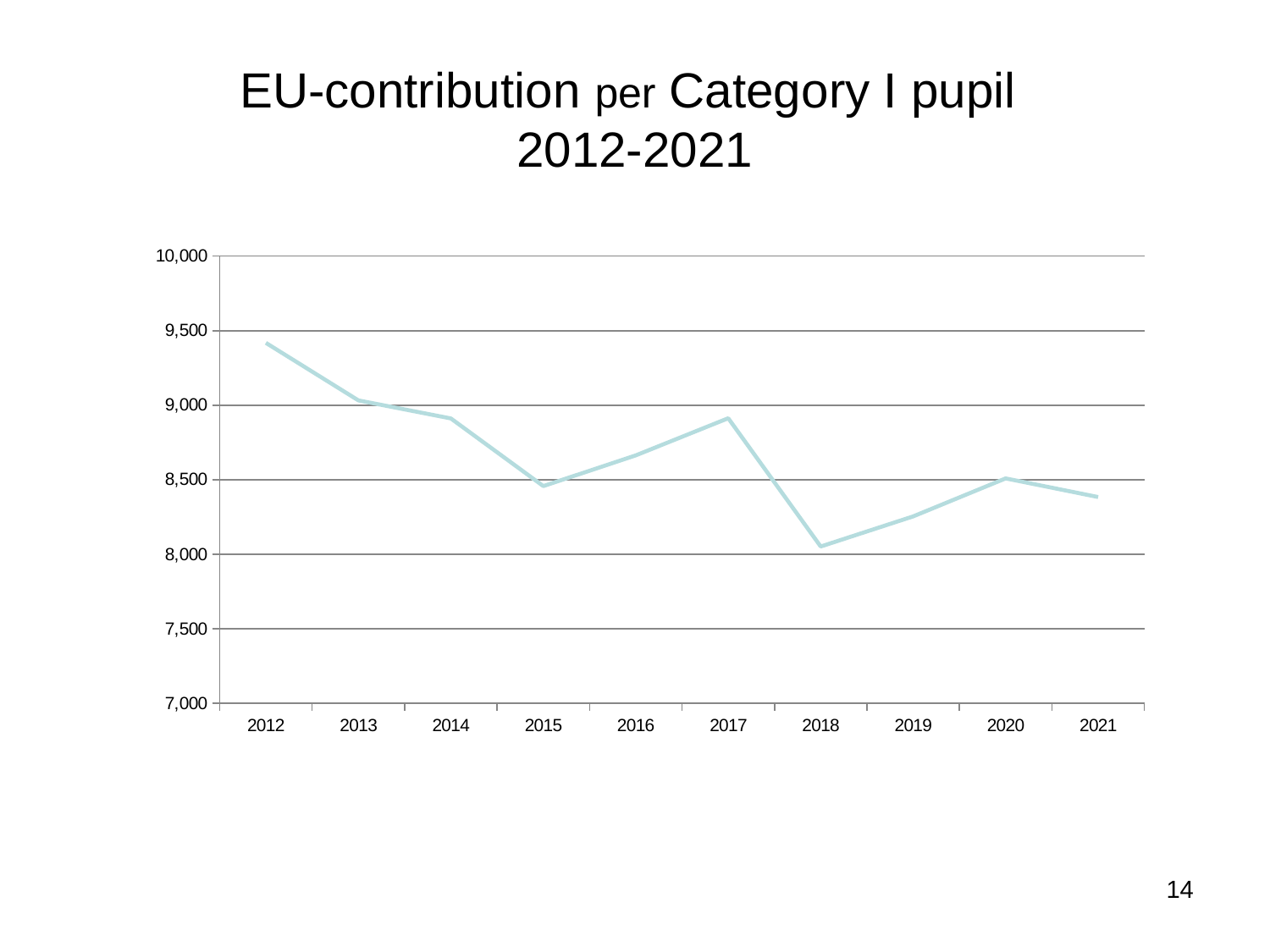
How many years are plotted on the x axis? 10 Is the value for 2012 greater or less than 9,000? greater Is the value for 2016 greater or less than 8,500? greater Is the value for 2018 greater or less than 8,500? less Which year has the lowest EU-contribution per Category I pupil? 2018 What kind of chart is shown on the slide? line chart Overall, do the values rise or fall from 2012 to 2021? fall Which year has the highest EU-contribution per Category I pupil? 2012 What is the title of the chart? EU-contribution per Category I pupil 2012-2021 Which is larger, the value for 2017 or the value for 2018? 2017